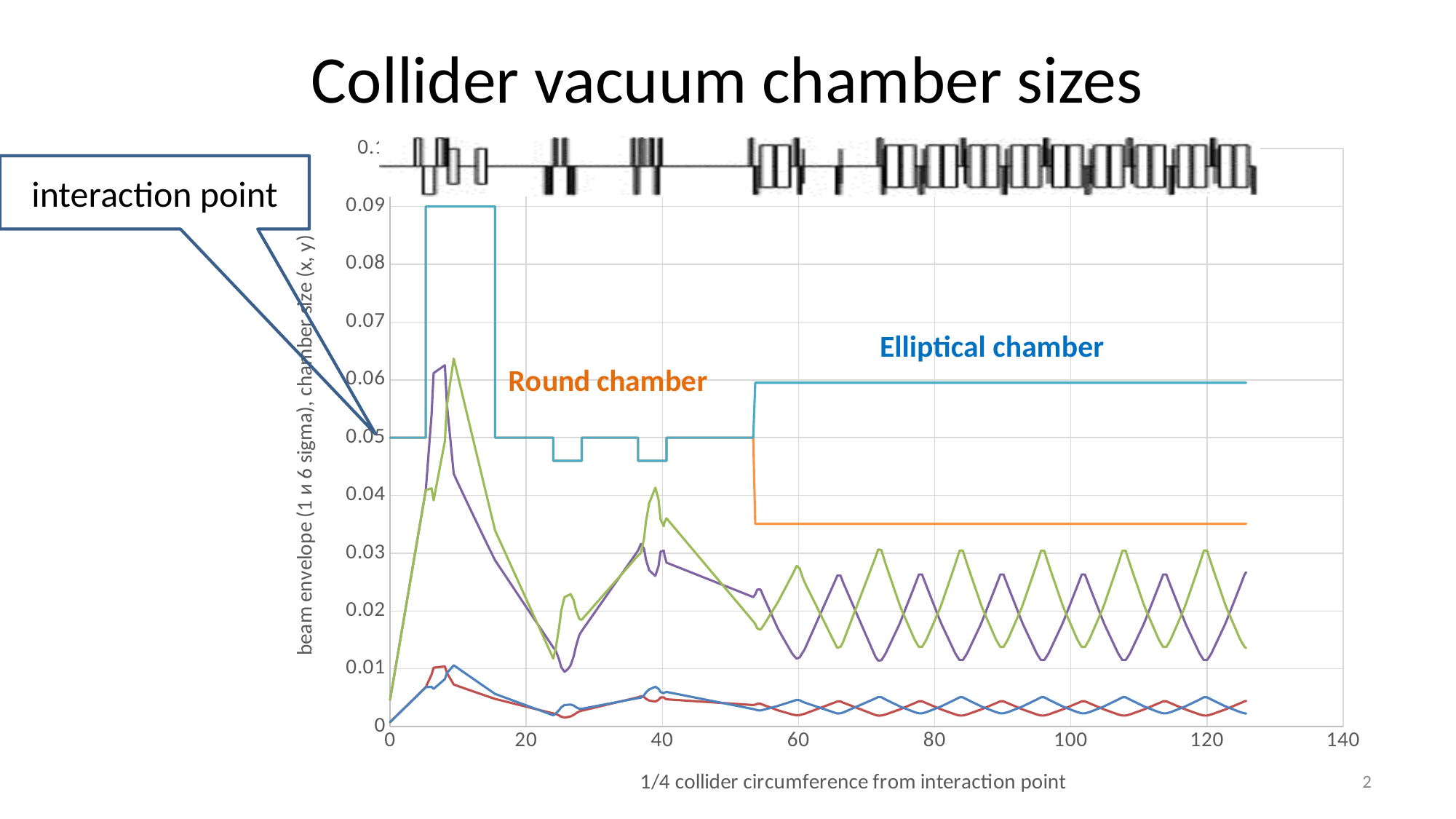
What is the highest value shown on the x axis? 140 What is the title of the slide's chart? Collider vacuum chamber sizes Is the value of the cyan line at x = 10 greater or less than 0.08? greater Is the value of the red line at x = 80 greater or less than 0.01? less What is the label of the x axis? 1/4 collider circumference from interaction point Does the purple line rise or fall between x = 0 and x = 8? rises What kind of chart is shown on the slide? line chart At x = 100, which line is higher: the cyan line or the orange line? the cyan line Is the value of the cyan chamber-size line at x = 100 greater or less than 0.05? greater Does the orange line rise, fall, or stay flat between x = 60 and x = 120? stays flat